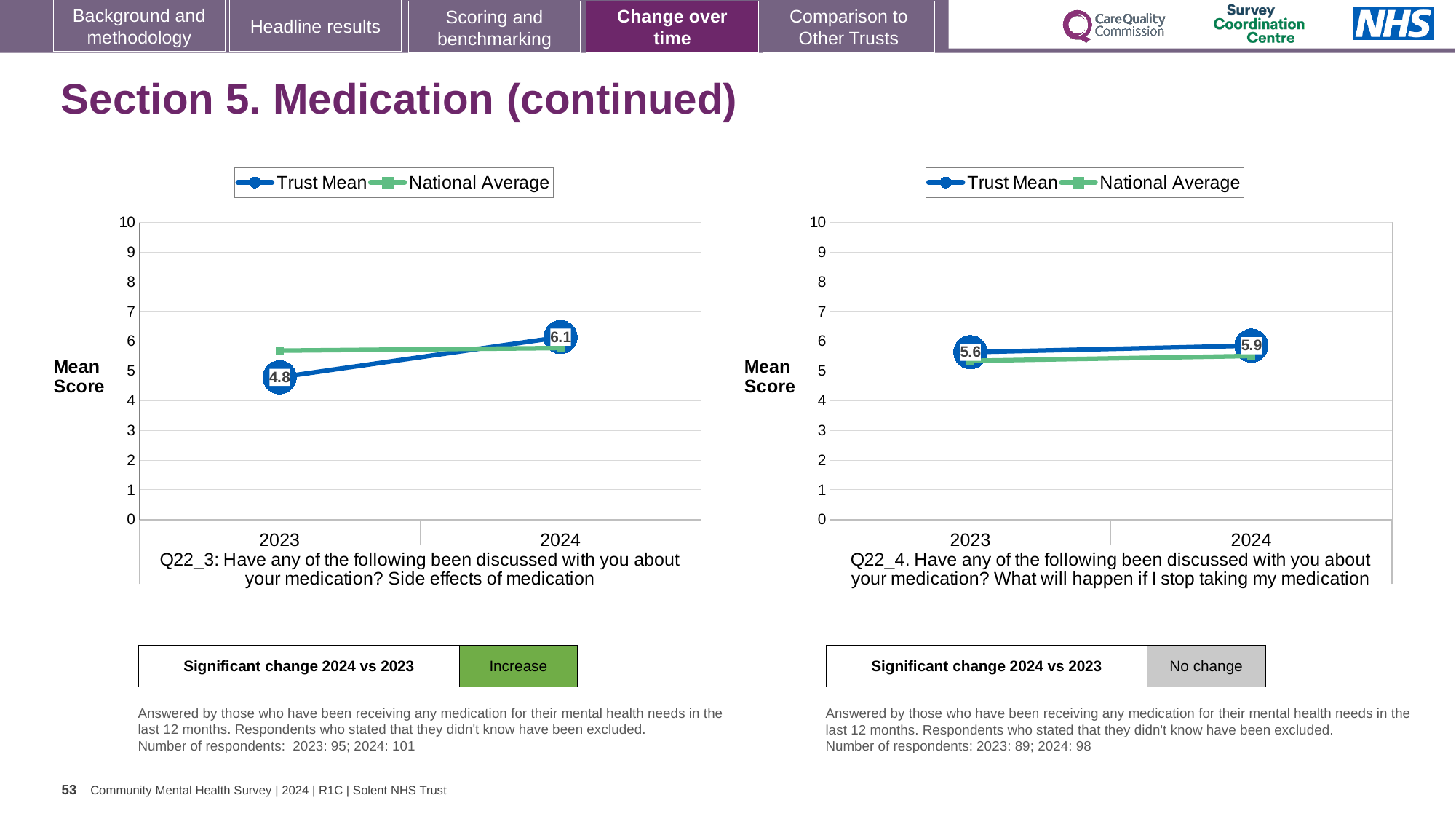
In the left chart (Q22_3), what is the Trust Mean score for 2024? 6.1 In the left chart (Q22_3), which is larger for 2023: the Trust Mean or the National Average? National Average In the left chart (Q22_3), does the Trust Mean rise or fall from 2023 to 2024? rise In the right chart (Q22_4), what is the Trust Mean score for 2024? 5.9 In the left chart (Q22_3), by how much did the Trust Mean change from 2023 to 2024? 1.3 What kind of chart is used on this slide? line chart In the left chart (Q22_3), what is the Trust Mean score for 2023? 4.8 How many years are plotted on the x axis of the right chart (Q22_4)? 2 In the right chart (Q22_4), what is the Trust Mean score for 2023? 5.6 In the right chart (Q22_4), what is the difference between the Trust Mean for 2024 and 2023? 0.3 How many series does the legend of the left chart list? 2 In the left chart (Q22_3), is the National Average for 2023 greater or less than 5? greater